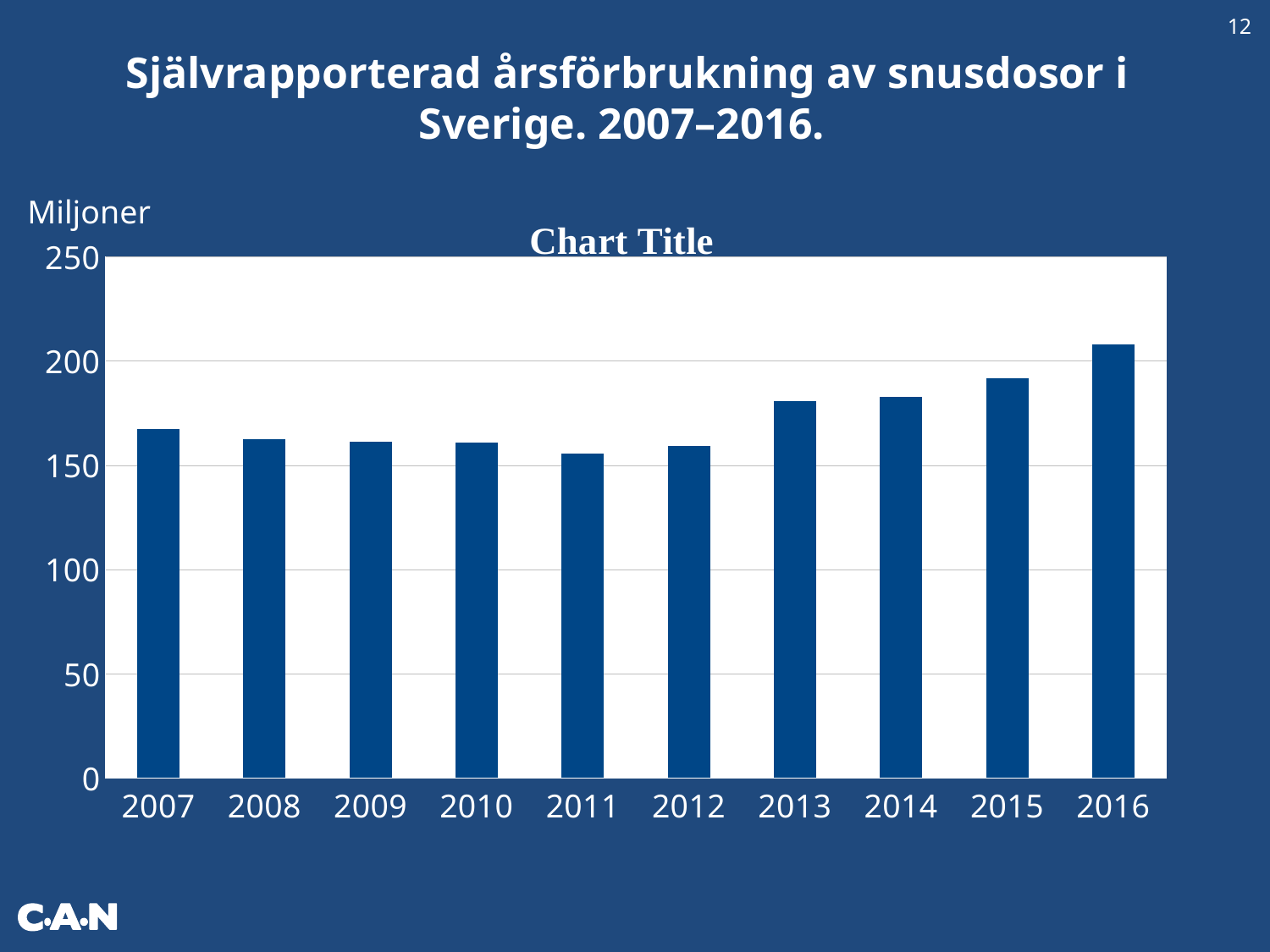
Which is larger, the value for 2016 or the value for 2007? 2016 Which year has the highest value in the chart? 2016 Is the value for 2007 greater or less than 200? less Is the value for 2016 greater or less than 200? greater Is the value for 2013 greater or less than 200? less Which is larger, the value for 2013 or the value for 2012? 2013 Which year has the lowest value in the chart? 2011 Do the values rise or fall from 2012 to 2016? rise What unit label is shown above the y axis of the chart? Miljoner What kind of chart is shown on the slide? bar chart How many years are shown on the x axis of the chart? 10